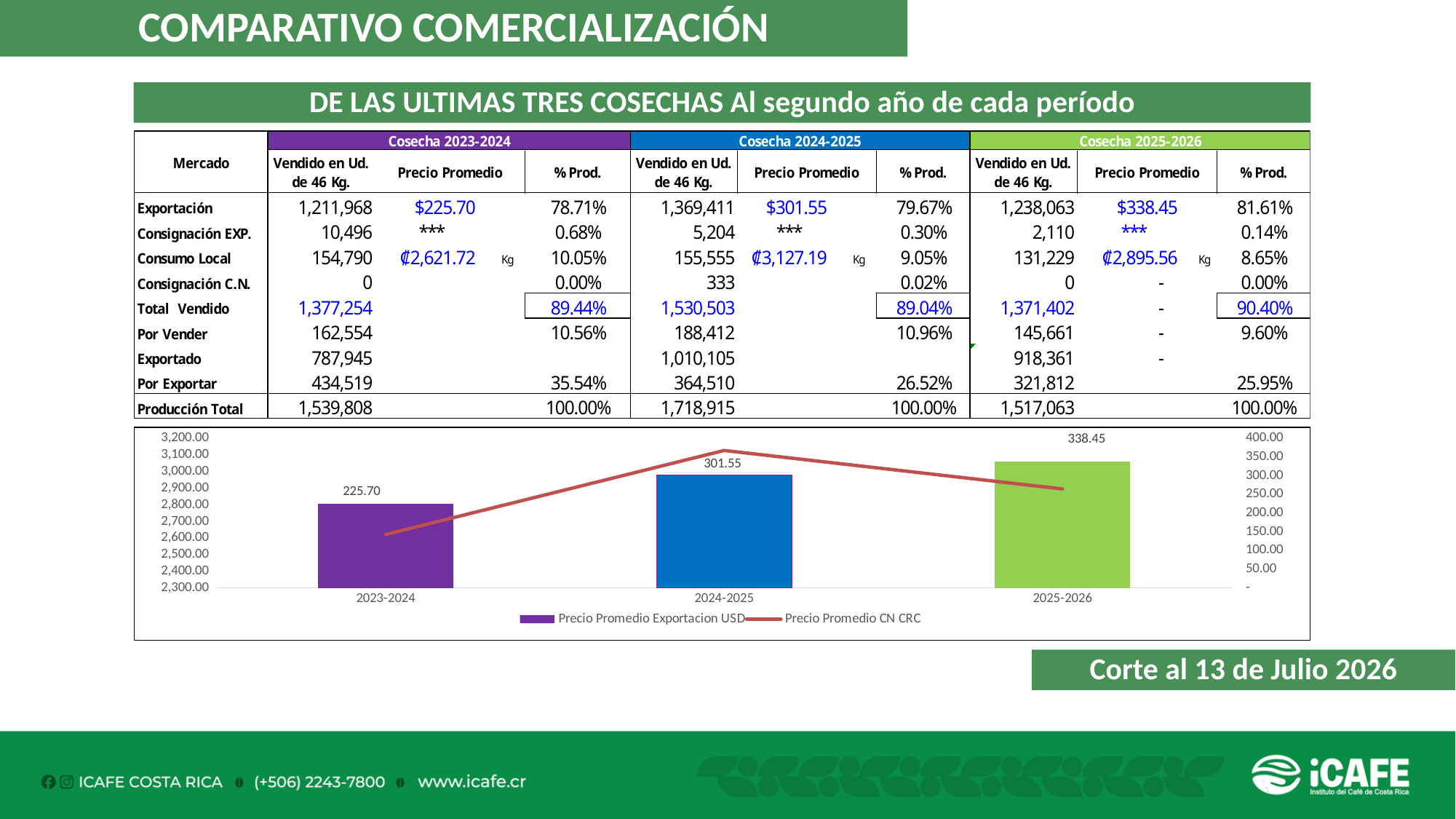
How many harvest periods are shown on the x axis of the chart? 3 Which harvest period has the lowest Precio Promedio Exportacion USD bar? 2023-2024 What is the difference between the bar values for 2025-2026 and 2023-2024? 112.75 What is the data label on the bar for 2025-2026? 338.45 Is the Precio Promedio CN CRC line value for 2024-2025 greater or less than 3,000.00? greater Which period has the highest point on the Precio Promedio CN CRC line? 2024-2025 How many series does the chart legend list? 2 Do the Precio Promedio Exportacion USD bars rise or fall from 2023-2024 to 2025-2026? rise Is the Precio Promedio CN CRC line value for 2023-2024 greater or less than 2,700.00? less What is the data label on the bar for 2024-2025? 301.55 What is the data label on the bar for 2023-2024? 225.70 Which harvest period has the highest Precio Promedio Exportacion USD bar? 2025-2026